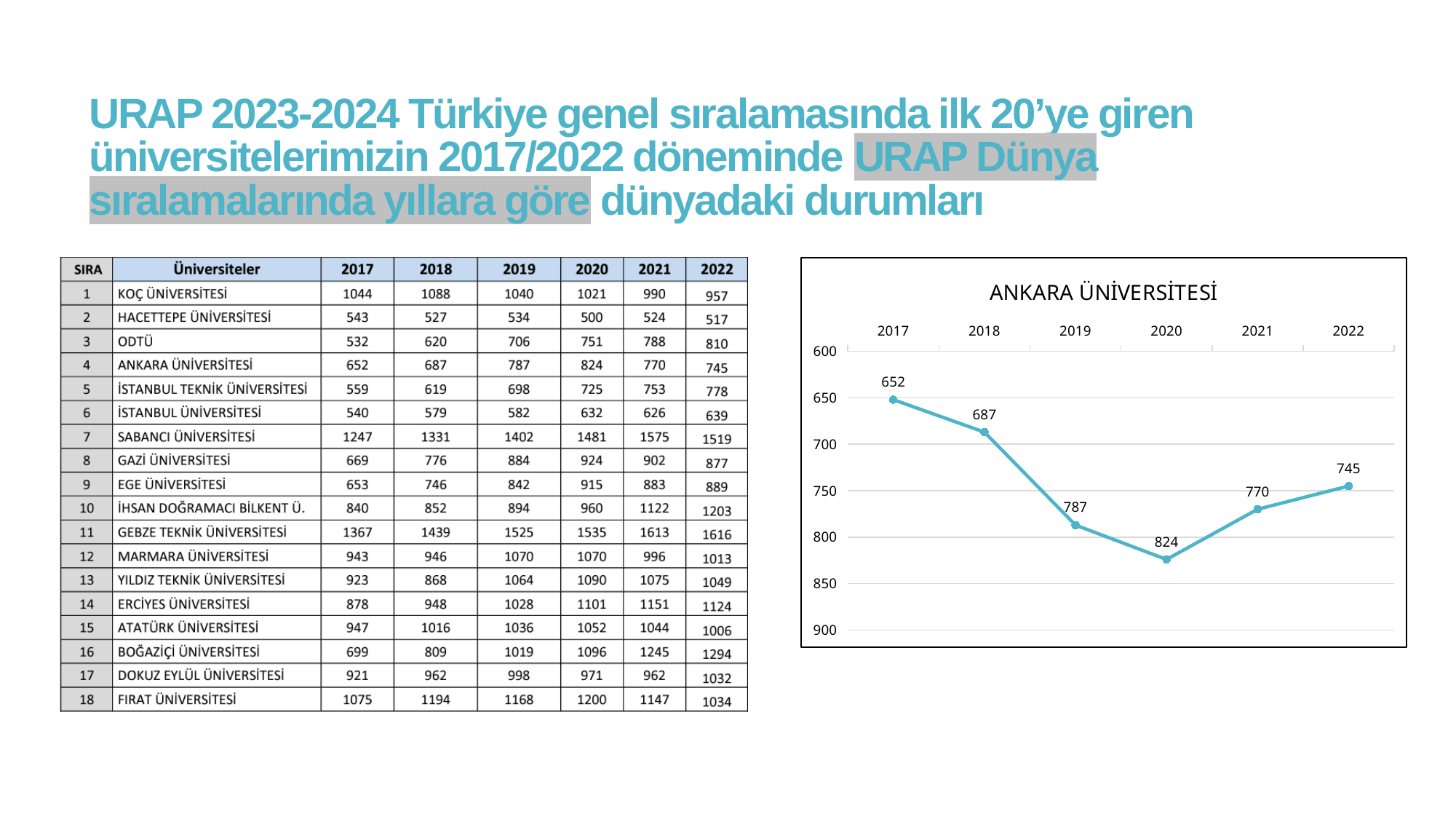
What is the value for 2022 in the Ankara Üniversitesi chart? 745 In the Ankara Üniversitesi chart, do the values increase or decrease from 2017 to 2020? Increase In the Ankara Üniversitesi chart, which is larger, the value for 2018 or the value for 2021? 2021 What is the value for 2020 in the Ankara Üniversitesi chart? 824 In the Ankara Üniversitesi chart, what is the difference between the values for 2020 and 2017? 172 In the Ankara Üniversitesi chart, which year has the largest value? 2020 In the Ankara Üniversitesi chart, what is the difference between the values for 2021 and 2022? 25 In the Ankara Üniversitesi chart, which year has the smallest value? 2017 What kind of chart is the Ankara Üniversitesi chart? Line chart How many data points are plotted in the Ankara Üniversitesi chart? 6 What is the value for 2019 in the Ankara Üniversitesi chart? 787 What is the value for 2017 in the Ankara Üniversitesi chart? 652